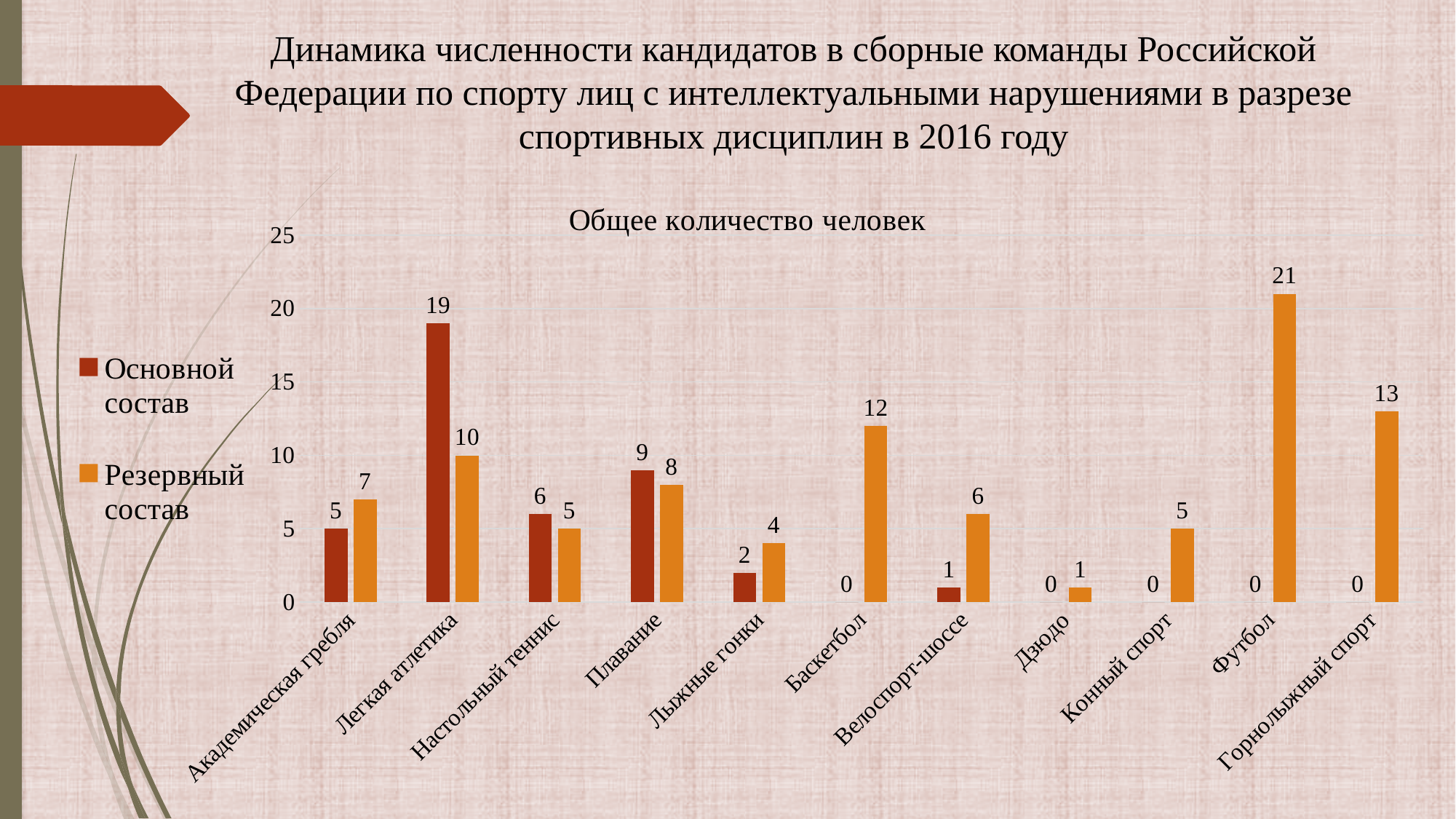
Which category has the highest value for Основной состав? Легкая атлетика What is the value for Резервный состав in Баскетбол? 12 What kind of chart is shown on the slide? Bar chart Which category has the lowest value for Резервный состав? Дзюдо How many series does the legend list? 2 Which category has the highest value for Резервный состав? Футбол What is the title of the chart? Общее количество человек Which is larger in Плавание: Основной состав or Резервный состав? Основной состав How many categories are shown on the x axis? 11 What is the value for Основной состав in Легкая атлетика? 19 What is the difference between Основной состав and Резервный состав in Легкая атлетика? 9 What is the value for Резервный состав in Футбол? 21